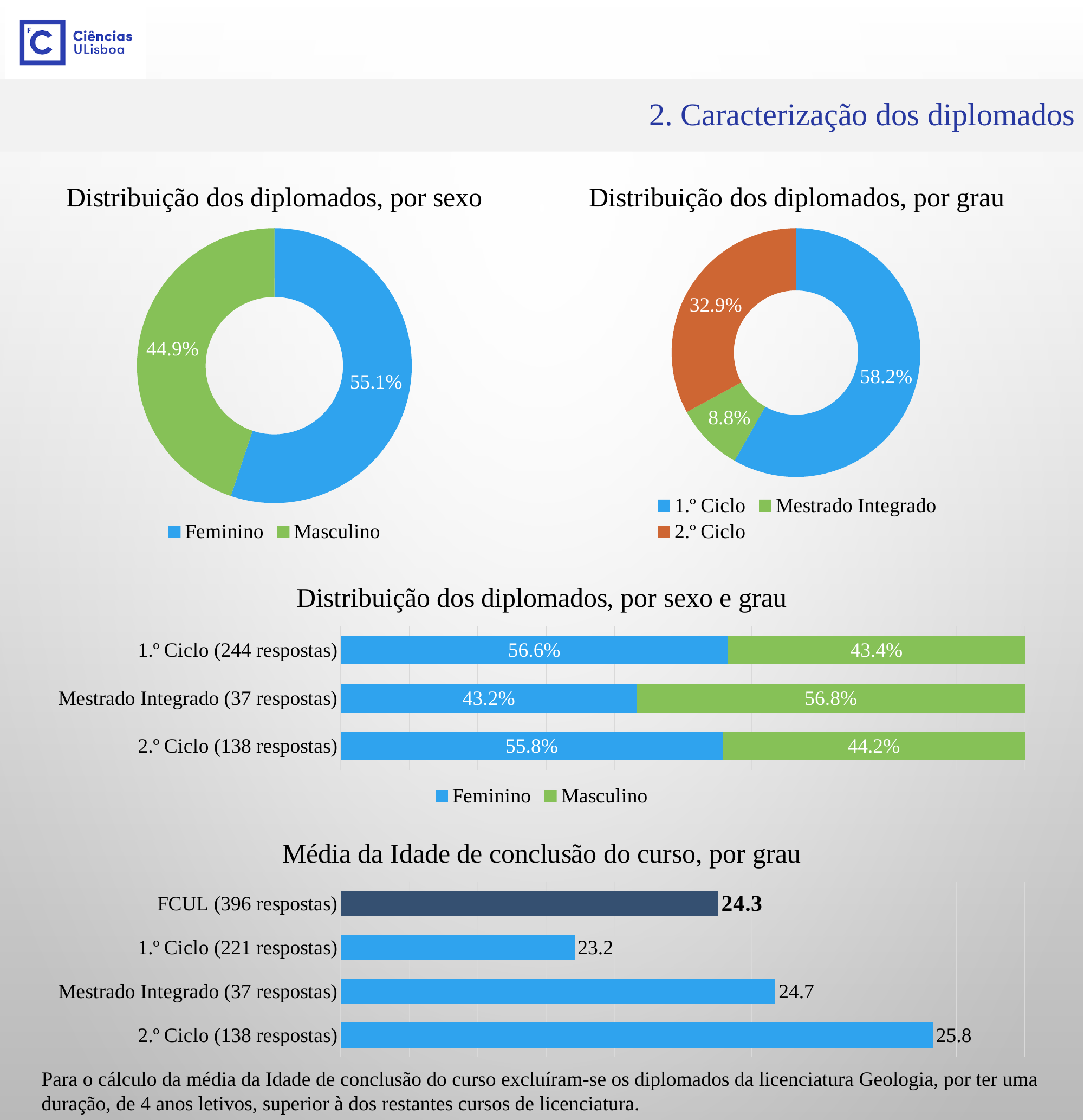
In the chart 'Distribuição dos diplomados, por sexo e grau', what is the Masculino value for 1.º Ciclo (244 respostas)? 43.4% In the chart 'Média da Idade de conclusão do curso, por grau', which category has the highest value? 2.º Ciclo (138 respostas) In the chart 'Distribuição dos diplomados, por sexo', what share of graduates is Masculino? 44.9% In the chart 'Distribuição dos diplomados, por sexo e grau', what is the Feminino value for Mestrado Integrado (37 respostas)? 43.2% In the chart 'Distribuição dos diplomados, por grau', how many categories does the legend list? 3 In the chart 'Distribuição dos diplomados, por grau', which category has the smallest share? Mestrado Integrado In the chart 'Média da Idade de conclusão do curso, por grau', what is the difference between 2.º Ciclo (138 respostas) and 1.º Ciclo (221 respostas)? 2.6 In the chart 'Distribuição dos diplomados, por sexo e grau', what is the difference between the Feminino and Masculino values for 2.º Ciclo (138 respostas)? 11.6% What kind of chart is 'Média da Idade de conclusão do curso, por grau'? bar chart In the chart 'Distribuição dos diplomados, por sexo', what share of graduates is Feminino? 55.1% In the chart 'Distribuição dos diplomados, por grau', what share is 2.º Ciclo? 32.9% In the chart 'Média da Idade de conclusão do curso, por grau', what is the value for FCUL (396 respostas)? 24.3